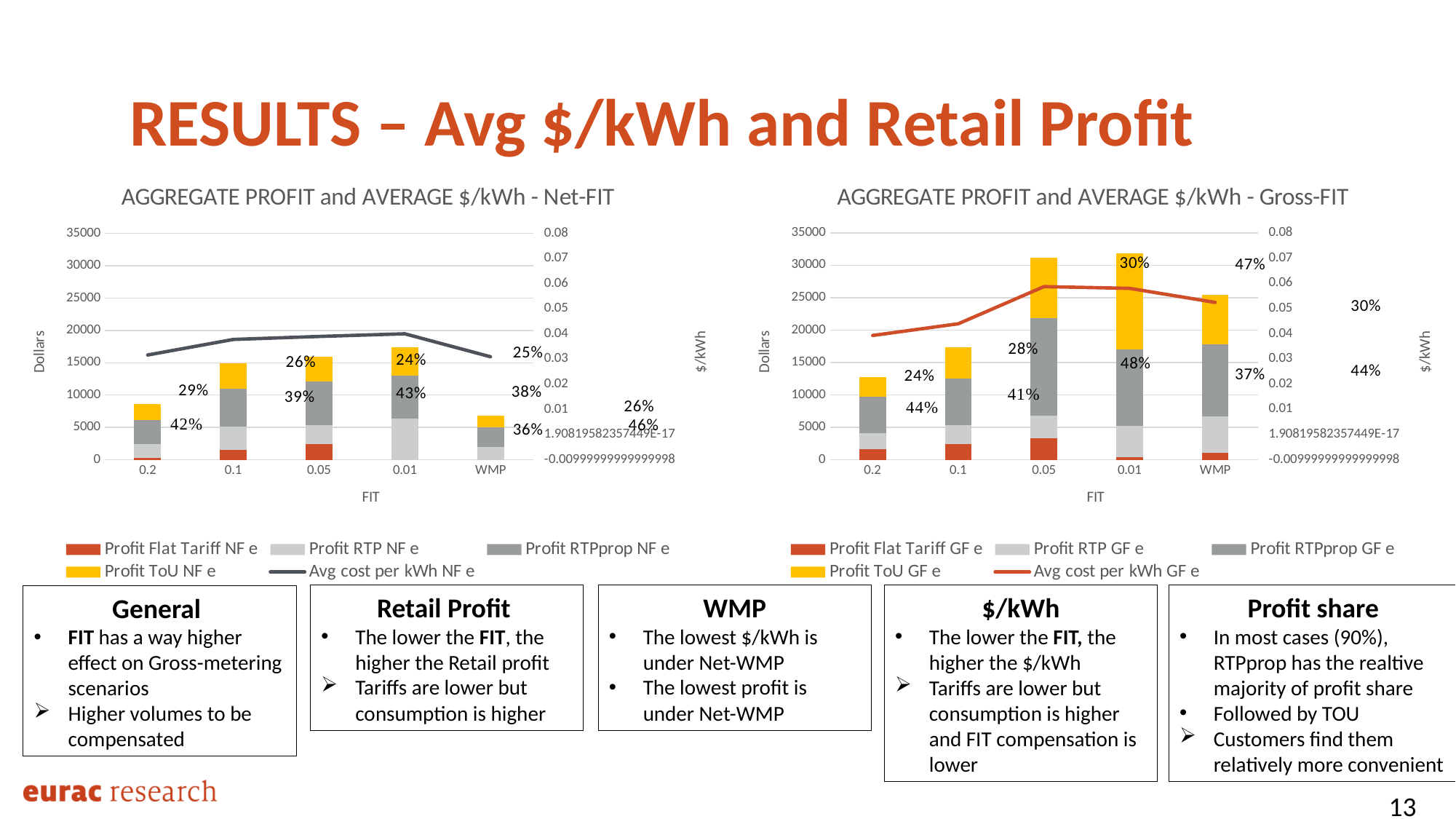
How many series does the legend of the AGGREGATE PROFIT and AVERAGE $/kWh - Net-FIT chart list? 5 How many categories are shown on the x axis of the AGGREGATE PROFIT and AVERAGE $/kWh - Gross-FIT chart? 5 What kind of chart is the AGGREGATE PROFIT and AVERAGE $/kWh - Net-FIT chart? Stacked bar chart with a line In the AGGREGATE PROFIT and AVERAGE $/kWh - Net-FIT chart, is the total stacked bar for WMP greater or less than 10000? less In the AGGREGATE PROFIT and AVERAGE $/kWh - Gross-FIT chart, which FIT category has the tallest stacked bar? 0.01 In the AGGREGATE PROFIT and AVERAGE $/kWh - Net-FIT chart, does the Avg cost per kWh NF e line rise or fall from 0.2 to 0.01? rise In the AGGREGATE PROFIT and AVERAGE $/kWh - Gross-FIT chart, is the total stacked bar for 0.05 greater or less than 30000? greater In the AGGREGATE PROFIT and AVERAGE $/kWh - Gross-FIT chart, which FIT category has the shortest stacked bar? 0.2 In the AGGREGATE PROFIT and AVERAGE $/kWh - Gross-FIT chart, which stacked bar is taller, 0.05 or WMP? 0.05 In the AGGREGATE PROFIT and AVERAGE $/kWh - Gross-FIT chart, is the total stacked bar for 0.2 greater or less than 10000? greater In the AGGREGATE PROFIT and AVERAGE $/kWh - Gross-FIT chart, which legend entry is plotted as a line rather than a bar? Avg cost per kWh GF e In the AGGREGATE PROFIT and AVERAGE $/kWh - Net-FIT chart, which FIT category has the shortest stacked bar? WMP